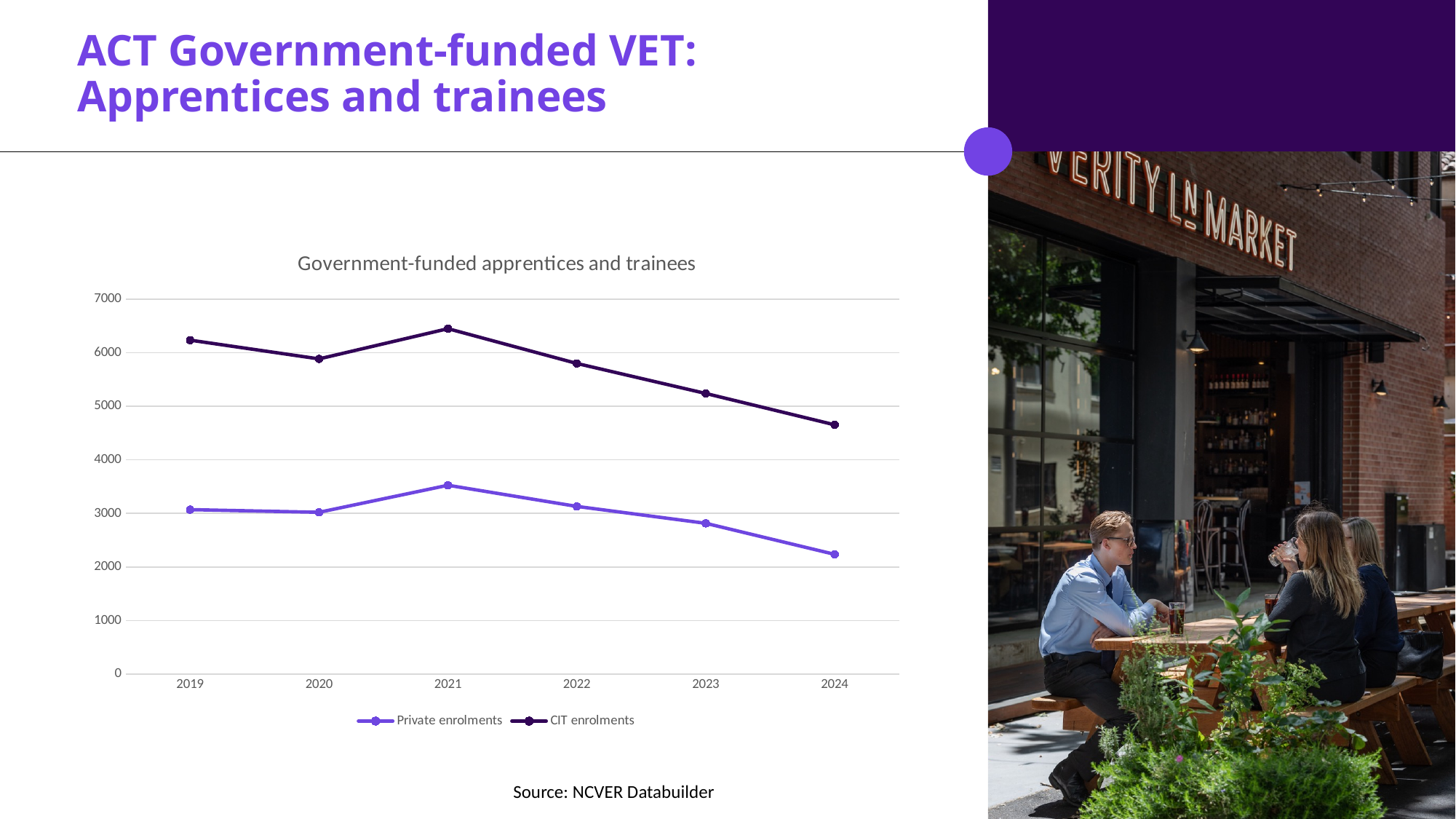
Is the value for Private enrolments in 2021 greater or less than 3000? greater Is the value for CIT enrolments in 2021 greater or less than 6000? greater Which series is plotted in the lighter purple colour? Private enrolments Which is larger: CIT enrolments in 2019 or CIT enrolments in 2020? 2019 How many years are plotted on the x axis? 6 What type of chart is shown on the slide? Line chart Do CIT enrolments rise or fall from 2021 to 2024? fall In which year is the Private enrolments series at its lowest? 2024 How many series does the legend list? 2 Is the value for CIT enrolments in 2024 greater or less than 5000? less What is the title of the chart? Government-funded apprentices and trainees In which year is the CIT enrolments series at its highest? 2021